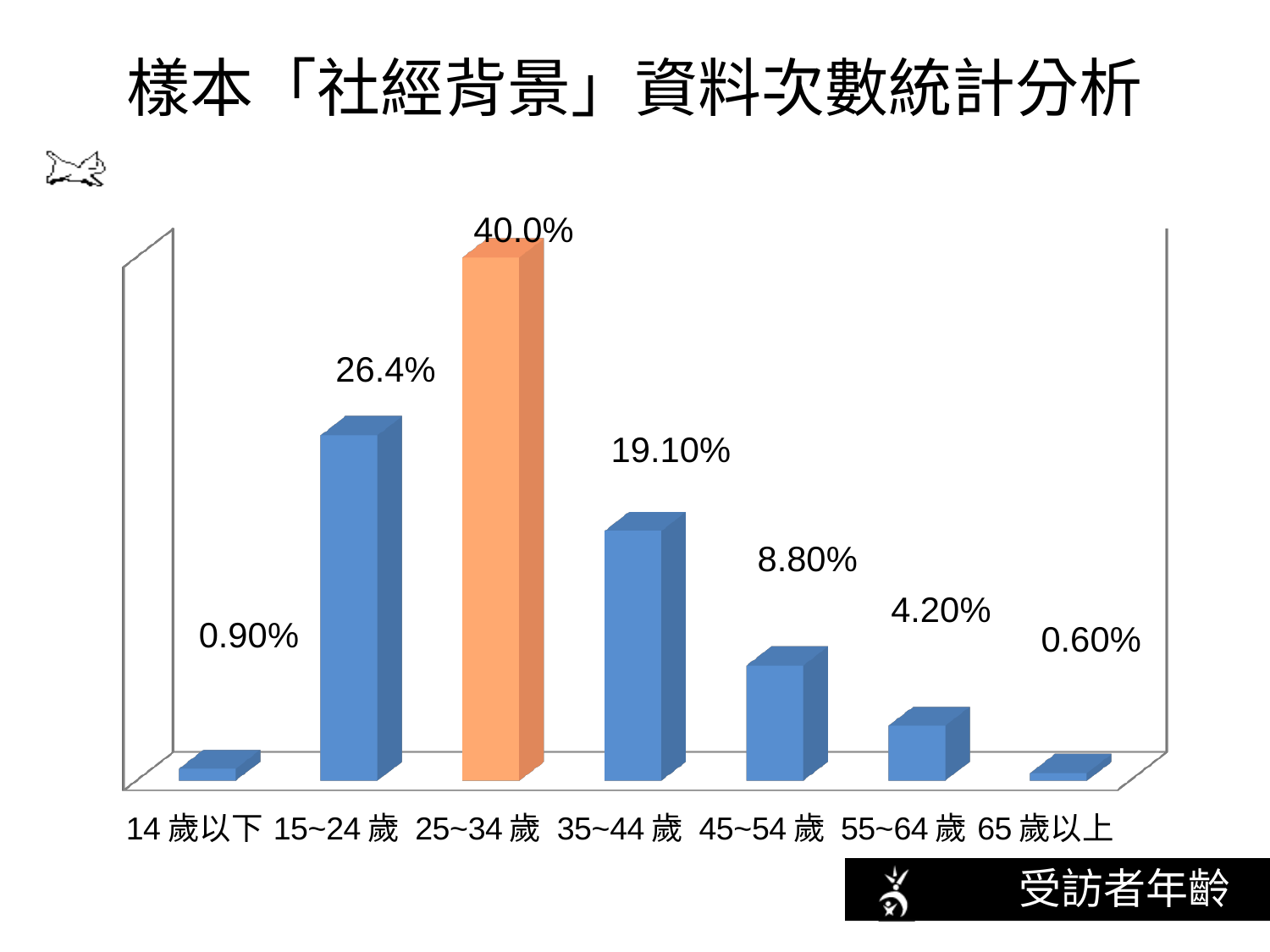
What is the value for 45~54 歲? 8.80% What is the difference between the values for 45~54 歲 and 55~64 歲? 4.60% What is the value for 25~34 歲? 40.0% Which age group has the highest value? 25~34 歲 What is the value for 15~24 歲? 26.4% What is the value for 65 歲以上? 0.60% Moving from 25~34 歲 to 65 歲以上 along the x axis, do the values rise or fall? fall What kind of chart is shown on the slide? bar chart What is the difference between the values for 25~34 歲 and 15~24 歲? 13.6% Which is larger, the value for 35~44 歲 or the value for 45~54 歲? 35~44 歲 Which age group has the lowest value? 65 歲以上 How many age categories are shown on the x axis? 7